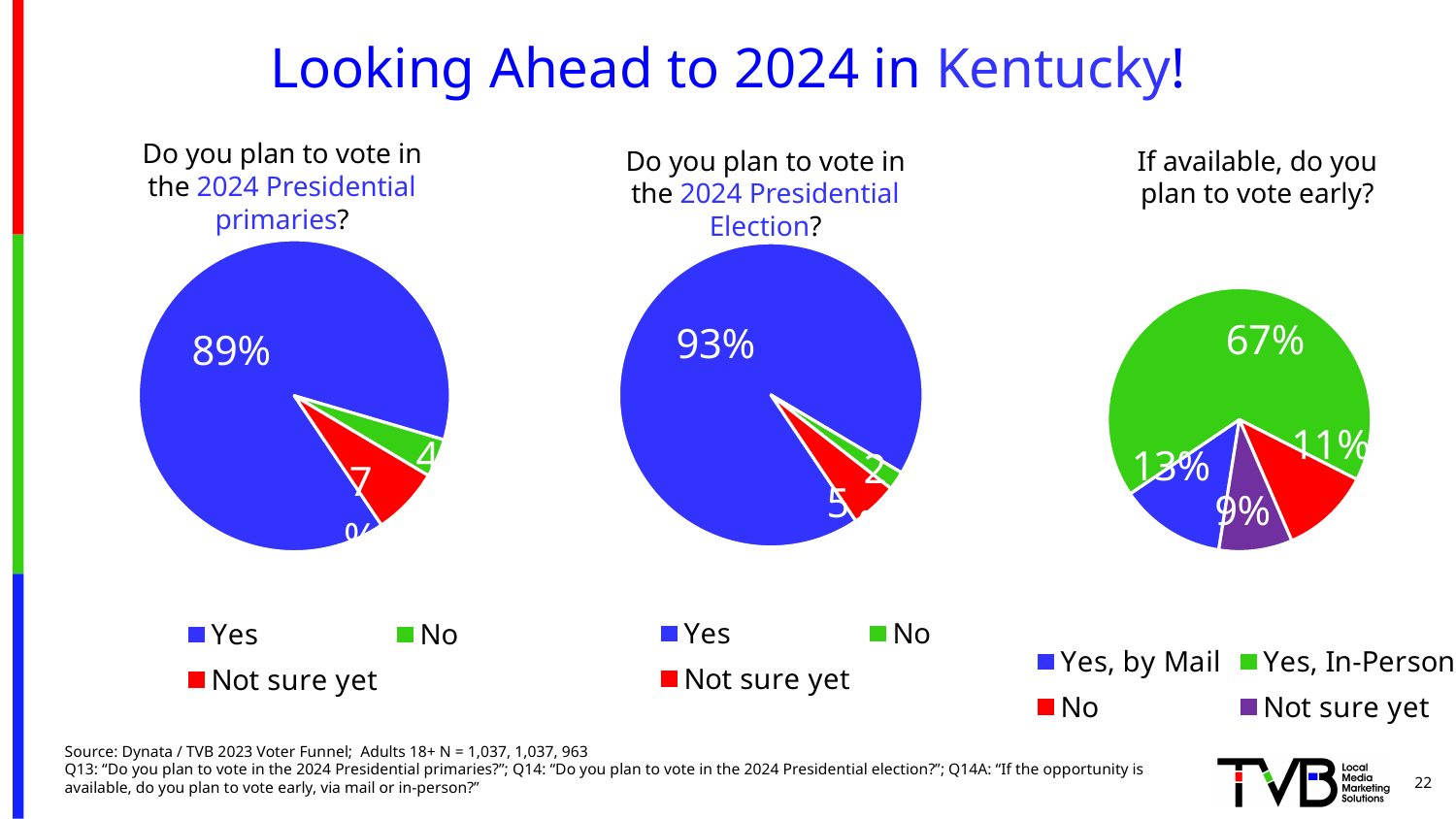
What type of chart is used for 'Do you plan to vote in the 2024 Presidential Election?' Pie chart In the chart 'Do you plan to vote in the 2024 Presidential Election?', what share of respondents answered Yes? 93% In the chart 'If available, do you plan to vote early?', which response has the largest share? Yes, In-Person In the chart 'If available, do you plan to vote early?', what share answered 'Yes, by Mail'? 13% In the chart 'If available, do you plan to vote early?', how many percentage points larger is 'Yes, In-Person' than 'Yes, by Mail'? 54 What colour represents 'Yes' in the chart 'Do you plan to vote in the 2024 Presidential primaries?' Blue In the chart 'Do you plan to vote in the 2024 Presidential primaries?', what share of respondents answered Yes? 89% In the chart 'If available, do you plan to vote early?', which is larger: the share for 'No' or the share for 'Not sure yet'? No In the chart 'If available, do you plan to vote early?', which response has the smallest share? Not sure yet In the chart 'If available, do you plan to vote early?', what share answered 'Not sure yet'? 9% In the chart 'If available, do you plan to vote early?', what share answered 'Yes, In-Person'? 67% How many categories does the legend list for the chart 'If available, do you plan to vote early?' 4